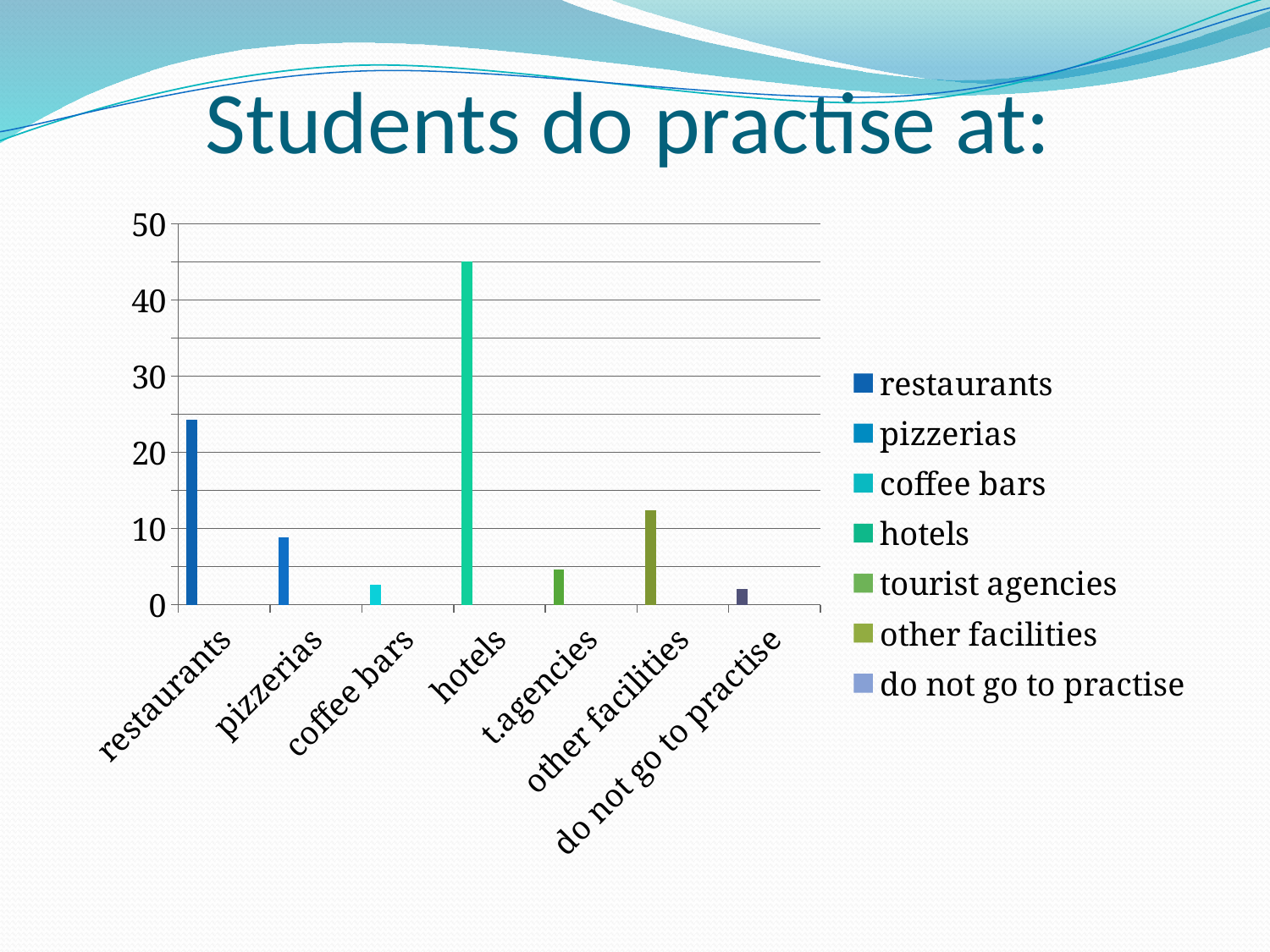
Which is larger, the value for other facilities or the value for t.agencies? other facilities Is the value for pizzerias greater or less than 10? less What kind of chart is shown on the slide? bar chart Is the value for hotels greater or less than 40? greater What is the title of the chart on the slide? Students do practise at: Which category has the highest bar in the chart? hotels How many categories are shown on the x axis of the chart? 7 Is the value for restaurants greater or less than 30? less Which is larger, the value for restaurants or the value for pizzerias? restaurants How many entries does the chart's legend list? 7